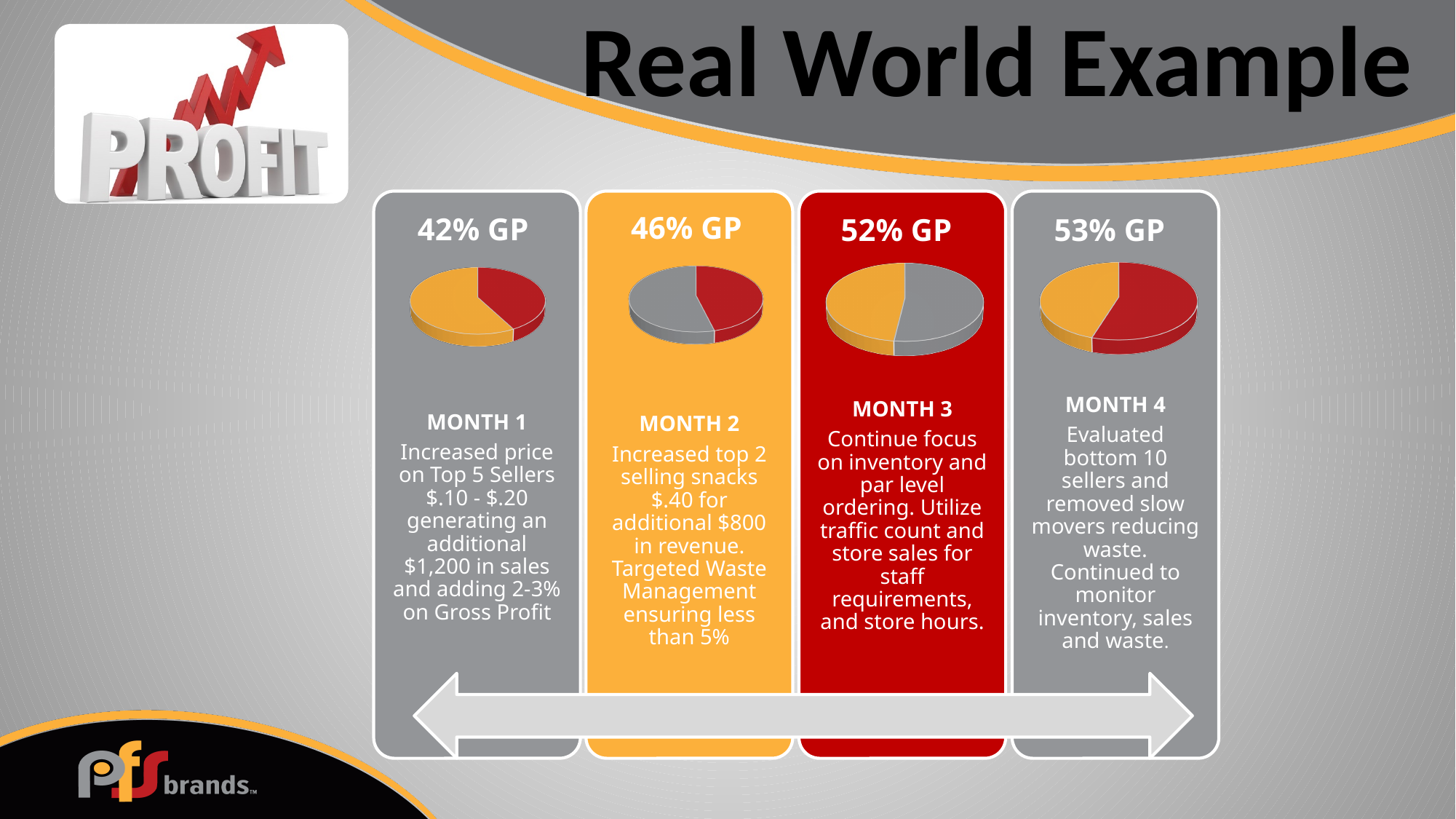
What kind of chart is used to show the GP percentage for each month? Pie chart Which has a higher GP percentage, Month 2 or Month 3? Month 3 What is the GP percentage shown for Month 1? 42% GP What is the GP percentage shown for Month 2? 46% GP What is the difference in GP percentage between Month 3 and Month 1? 10% What is the GP percentage shown for Month 3? 52% GP Which month has the highest GP percentage? Month 4 Which month has the lowest GP percentage? Month 1 Does the GP percentage rise or fall from Month 1 to Month 4? Rise How many pie charts are shown on the slide? 4 What is the GP percentage shown for Month 4? 53% GP What is the difference in GP percentage between Month 2 and Month 1? 4%